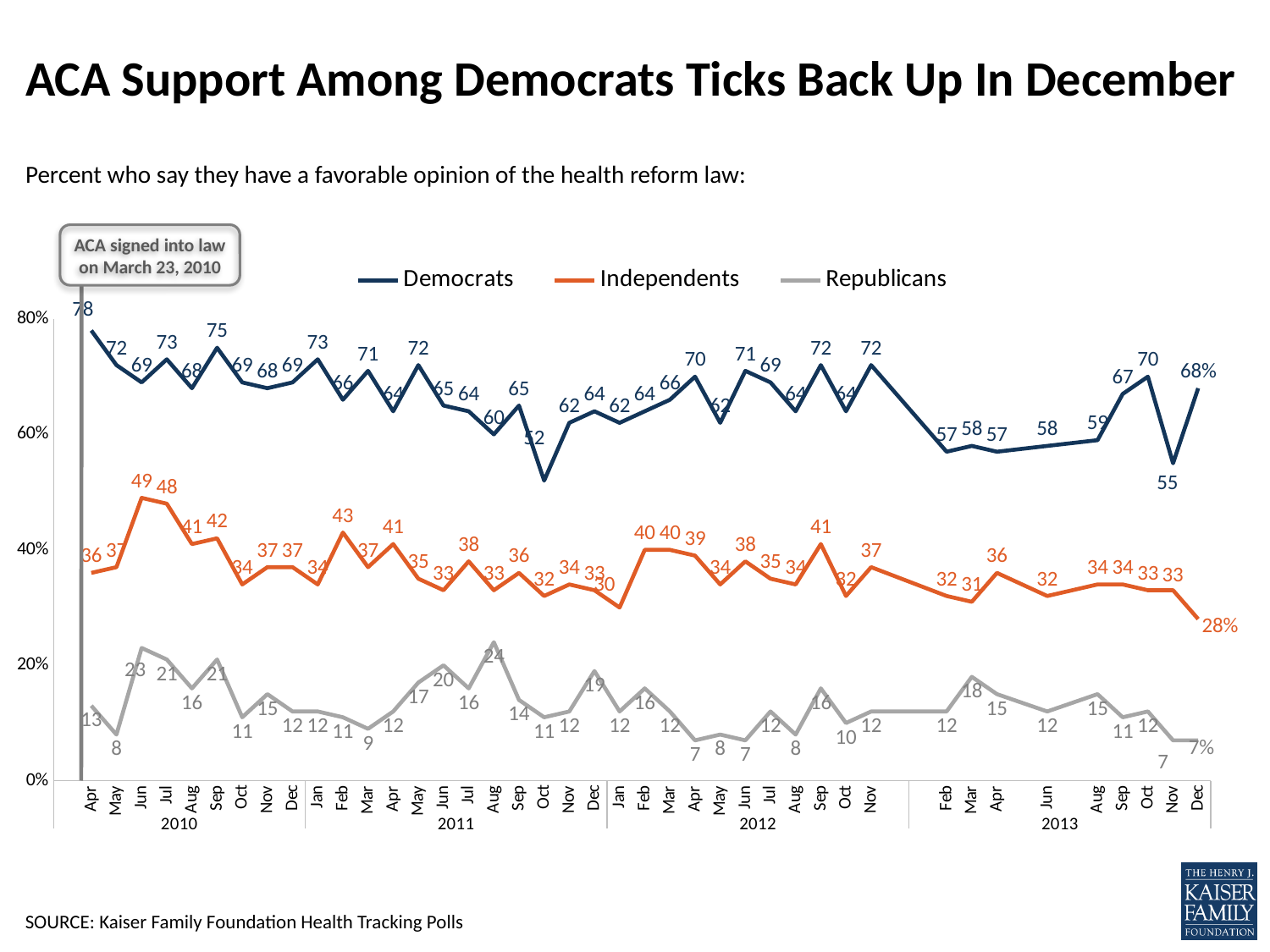
What is the highest value shown for Independents? 49 Which group has the higher value in June 2010, Independents or Republicans? Independents What is the value for Independents in December 2013? 28% What is the highest value shown for Republicans? 24 What is the value for Democrats in October 2011? 52 What is the value for Democrats in December 2013? 68% In which month does the Democrats line reach its highest value? April 2010 What is the lowest value shown for Democrats? 52 By how many points did the Democrats value rise from November 2013 to December 2013? 13 What is the value for Republicans in December 2013? 7% What kind of chart is shown on the slide? Line chart How many series does the legend list? 3